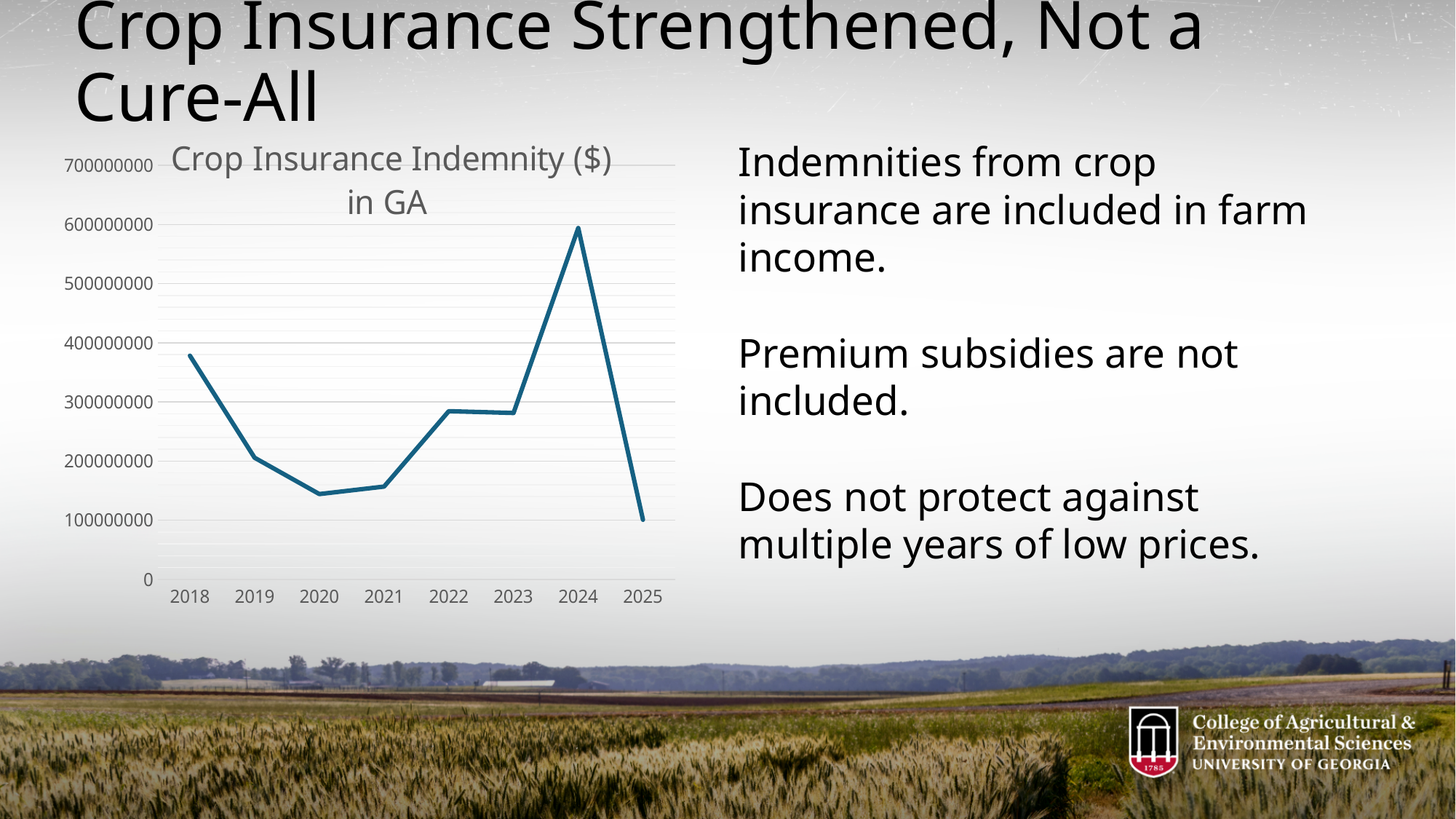
What is the title of the chart? Crop Insurance Indemnity ($) in GA Is the value for 2022 greater or less than 200000000? greater Is the value for 2020 greater or less than 200000000? less Do the values rise or fall from 2018 to 2020? fall Which year has the highest crop insurance indemnity in the chart? 2024 Is the value for 2024 greater or less than 500000000? greater What kind of chart is shown on the slide? Line chart Which year has the lowest crop insurance indemnity in the chart? 2025 Which year has a larger indemnity value, 2018 or 2019? 2018 Do the values rise or fall from 2024 to 2025? fall How many years are plotted on the x axis of the chart? 8